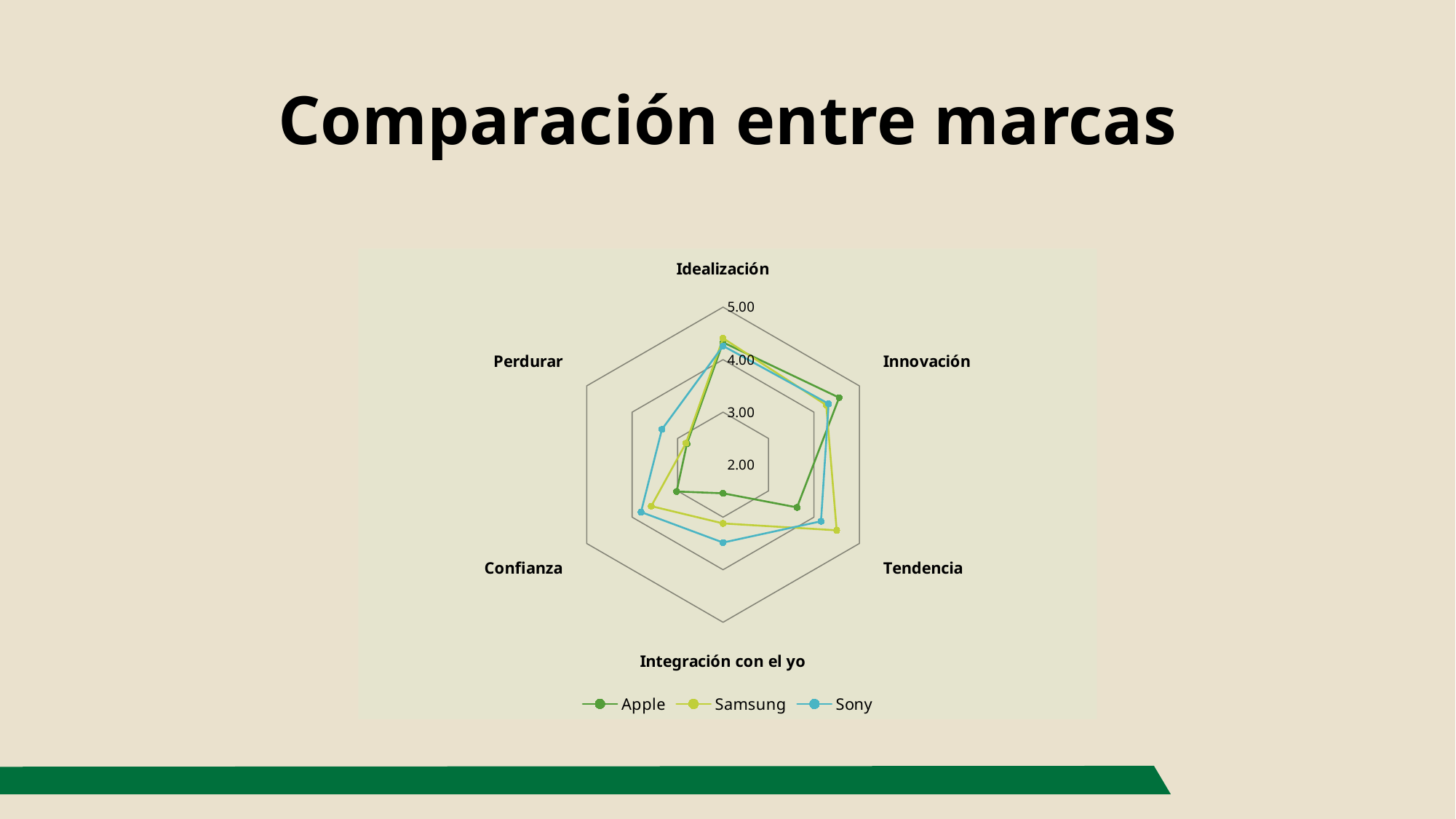
Which brands are listed in the legend? Apple, Samsung, Sony On Tendencia, which is larger: the value for Apple or the value for Samsung? Samsung Is the value for Apple on Tendencia greater or less than 4.00? less Which brand has the highest value on Integración con el yo? Sony Is the value for Apple on Integración con el yo greater or less than 3.00? less What is the highest value shown on the radar chart's axis scale? 5.00 Which brand has the lowest value on Confianza? Apple Is the value for Apple on Innovación greater or less than 4.00? greater How many series does the legend list? 3 What kind of chart is shown on the slide? radar chart How many categories (axes) does the radar chart have? 6